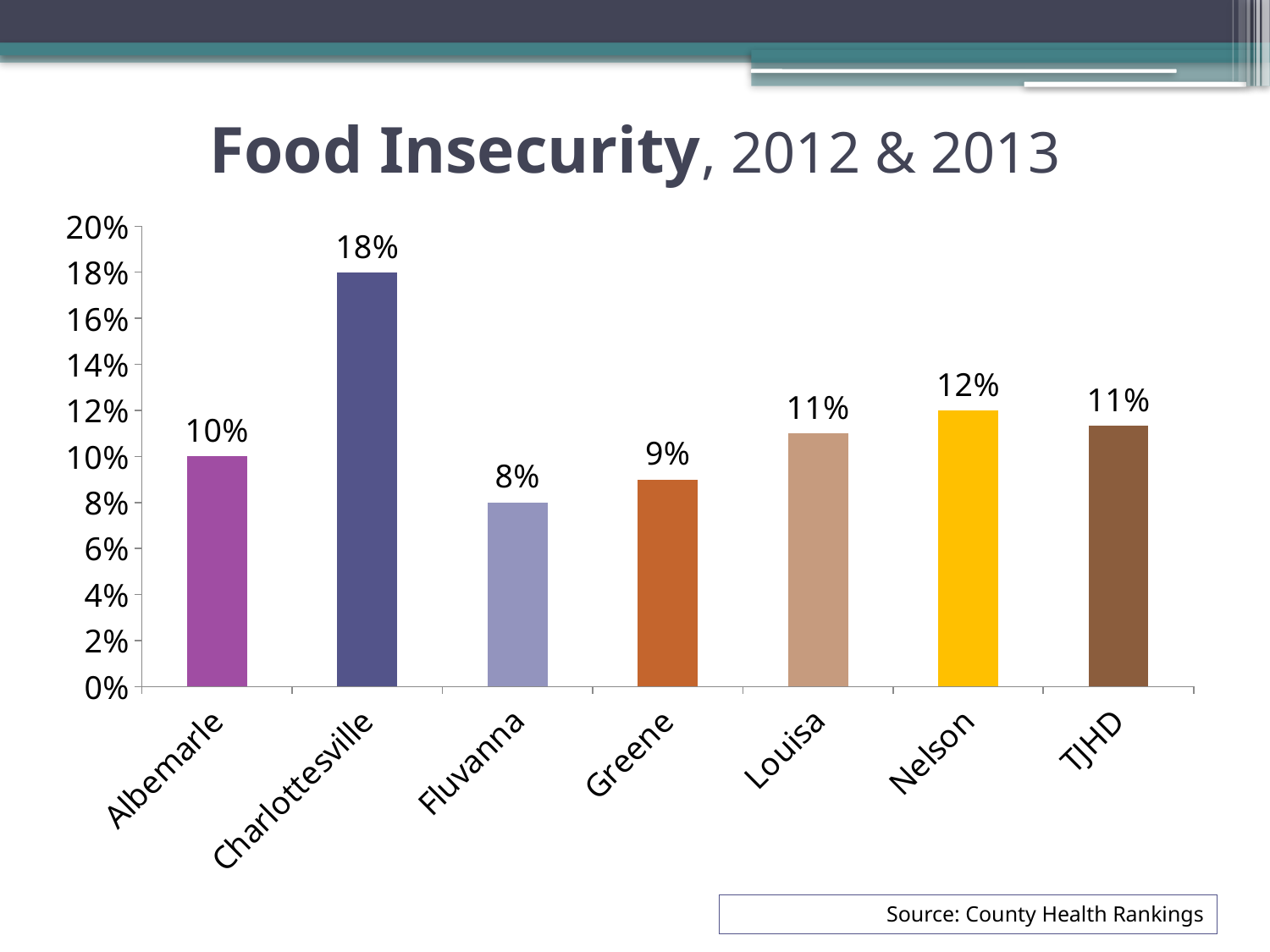
What kind of chart is shown on the slide? Bar chart Which has a higher food insecurity value, Albemarle or Nelson? Nelson What is the food insecurity value for Charlottesville? 18% What is the difference between the food insecurity values for Charlottesville and Fluvanna? 10% What is the food insecurity value for Nelson? 12% Which locality has the lowest food insecurity value? Fluvanna Is the value for Greene greater or less than 10%? less What is the food insecurity value for TJHD? 11% How many localities are shown on the chart? 7 What is the food insecurity value for Fluvanna? 8% Which locality has the highest food insecurity value? Charlottesville What is the source cited for the chart? County Health Rankings